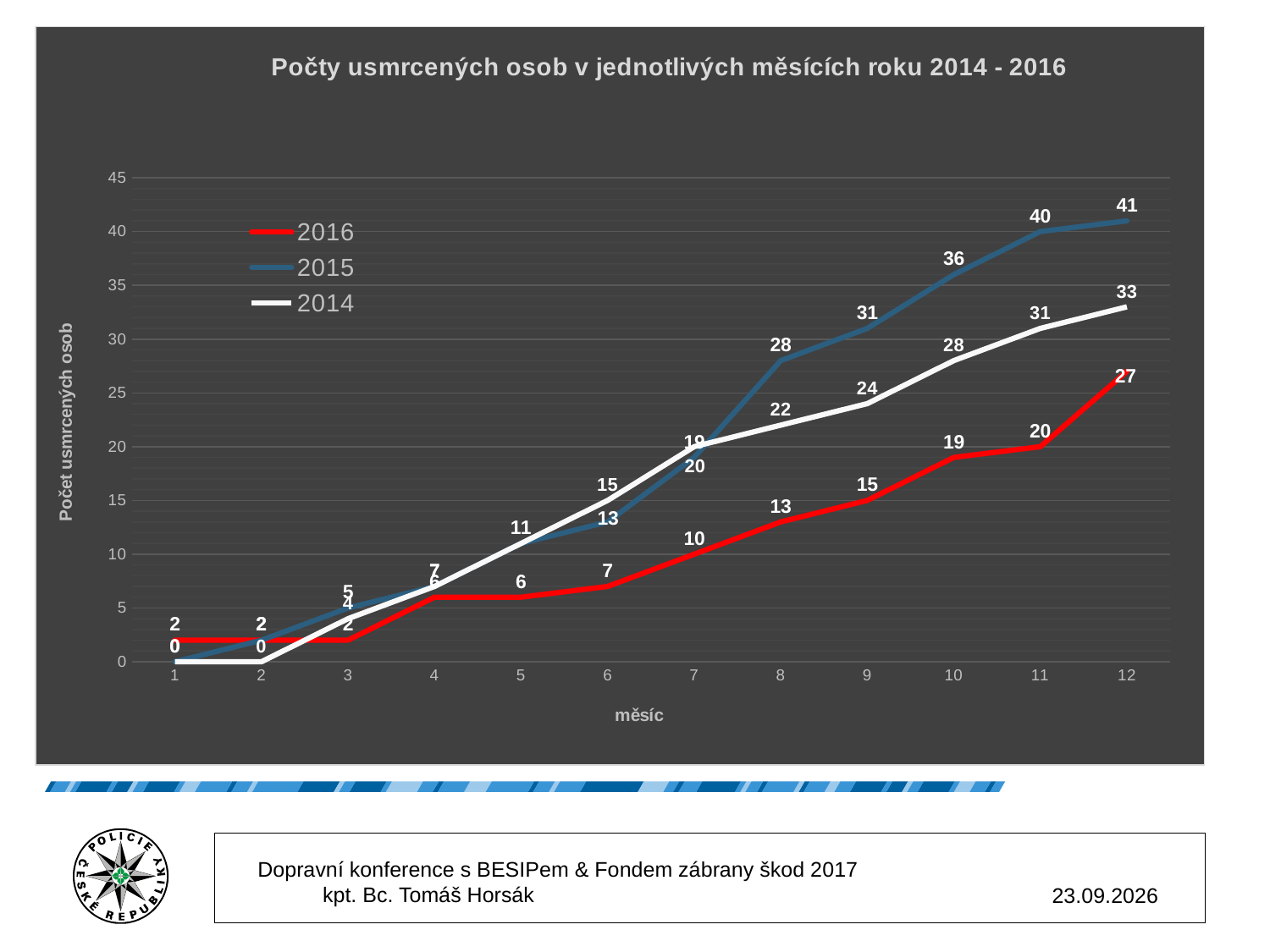
What is the value for 2014 in month 10? 28 What is the value for 2015 in month 12? 41 In month 8, which is larger: the value for 2015 or the value for 2014? 2015 What colour is the line for 2016? red What is the value for 2016 in month 9? 15 How many months are plotted on the x axis? 12 What is the value for 2016 in month 12? 27 Do the values for 2015 rise or fall from month 1 to month 12? rise What kind of chart is shown on the slide? line chart Which series has the highest value in month 12? 2015 How many series does the legend list? 3 What is the difference between the 2015 and 2014 values in month 12? 8